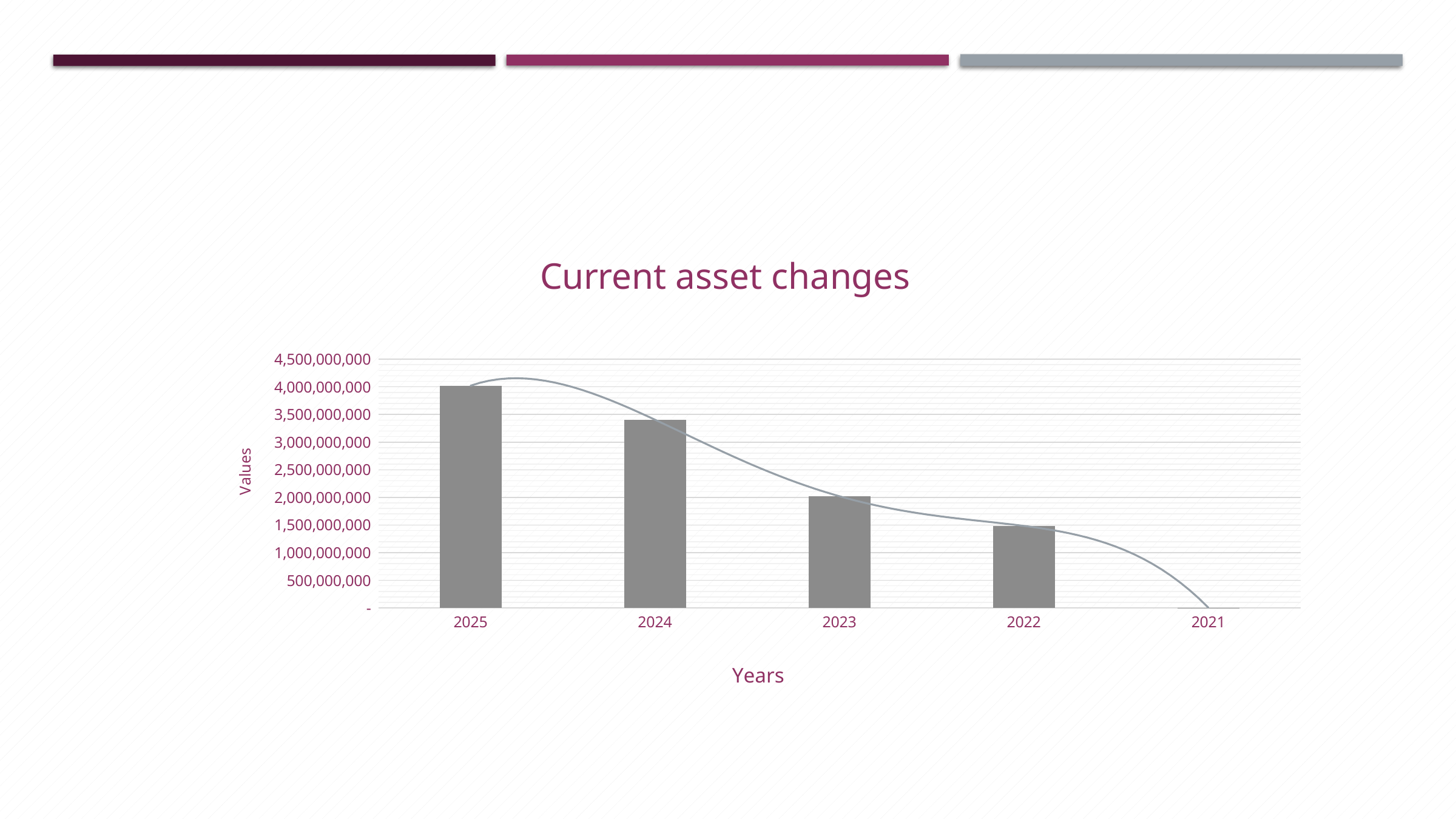
Do the bar values rise or fall moving from left to right along the x axis (from 2025 to 2021)? fall What is the title of the chart? Current asset changes Which year has the larger value, 2024 or 2023? 2024 Is the value for 2023 greater or less than 2,500,000,000? less Is the value for 2022 greater or less than 1,000,000,000? greater Which year has the larger value, 2022 or 2025? 2025 Is the value for 2024 greater or less than 3,000,000,000? greater What kind of chart is shown on the slide? bar chart Which year has the lowest bar in the chart? 2021 How many years are shown on the x axis of the chart? 5 Which year has the highest bar in the chart? 2025